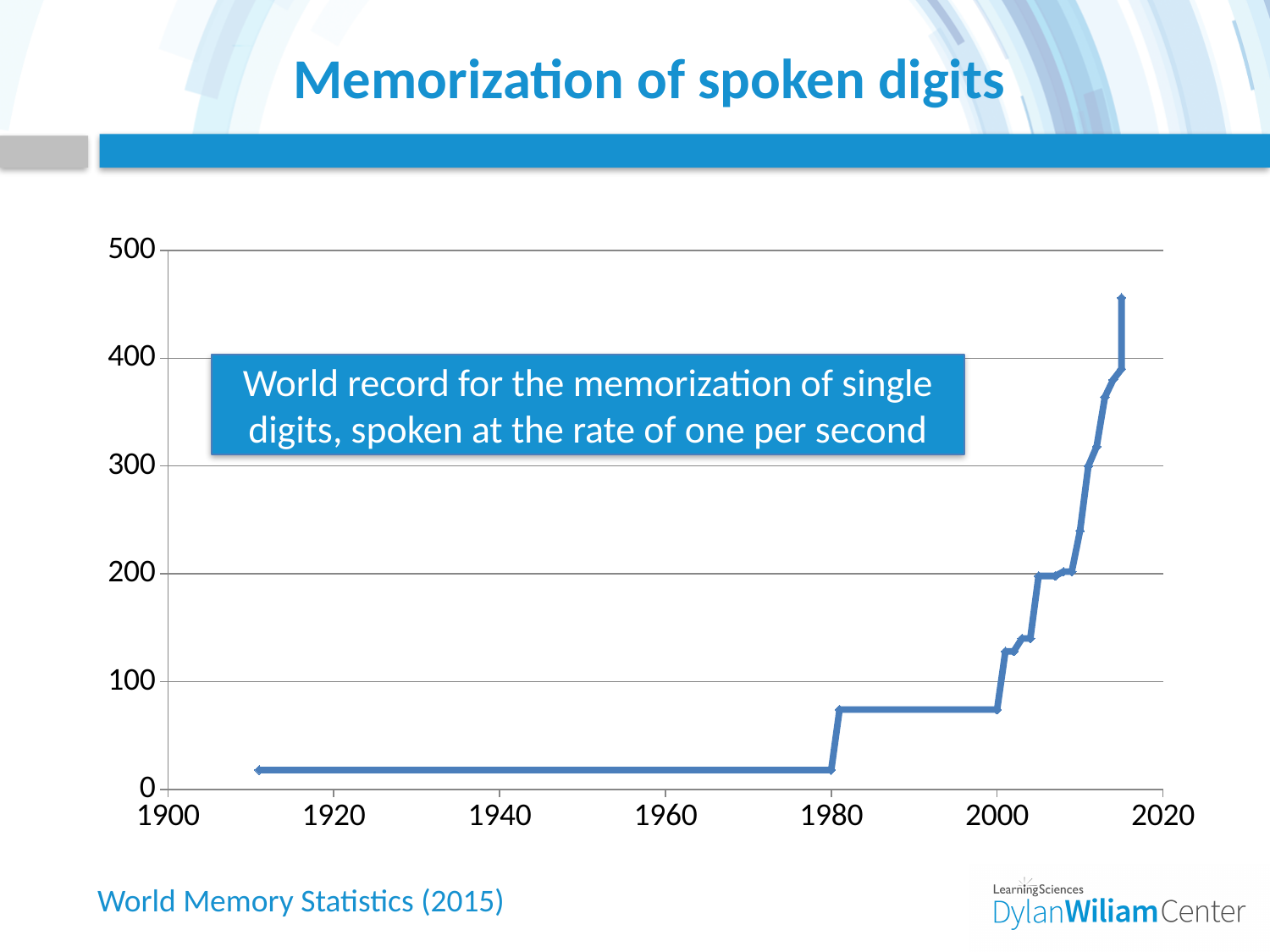
What is the title of the slide's chart? Memorization of spoken digits Is the value for the year 1980 greater or less than 100? less Do the values on the chart generally rise or fall as the years increase from 1900 to 2020? rise Is the value for the year 1920 greater or less than 100? less What is the highest value shown on the vertical axis of the chart? 500 Is the value for the year 1960 greater or less than 100? less Is the value for the year 2015 greater or less than the value for the year 2000? greater Is the value for the year 1990 greater or less than the value for the year 1970? greater What kind of chart is shown on the slide? line chart